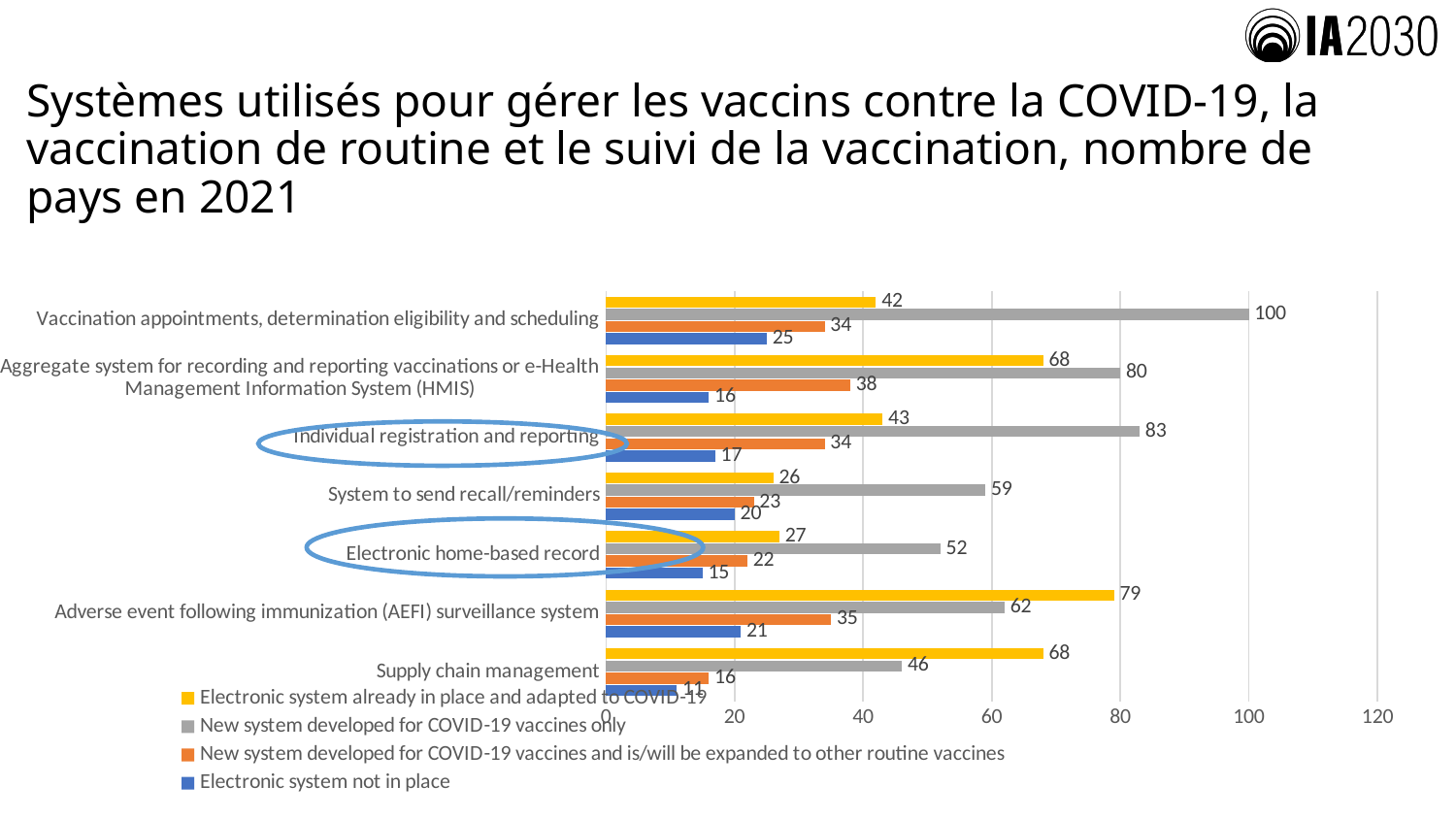
How many categories are shown on the chart? 7 What is the value for 'New system developed for COVID-19 vaccines only' in the 'Vaccination appointments, determination eligibility and scheduling' category? 100 What is the difference between the 'New system developed for COVID-19 vaccines only' value and the 'Electronic system already in place and adapted to COVID-19' value for 'Individual registration and reporting'? 40 How many series does the legend list? 4 What kind of chart is shown on the slide? Bar chart For 'Supply chain management', which is larger: 'Electronic system already in place and adapted to COVID-19' or 'New system developed for COVID-19 vaccines only'? Electronic system already in place and adapted to COVID-19 Which colour represents 'Electronic system not in place' in the chart? Blue What is the value for 'New system developed for COVID-19 vaccines and is/will be expanded to other routine vaccines' in the 'Electronic home-based record' category? 22 Which category has the highest value for 'New system developed for COVID-19 vaccines only'? Vaccination appointments, determination eligibility and scheduling What is the value for 'Electronic system not in place' in the 'Supply chain management' category? 11 What is the value for 'Electronic system already in place and adapted to COVID-19' in the 'Adverse event following immunization (AEFI) surveillance system' category? 79 Which category has the lowest value for 'Electronic system not in place'? Supply chain management